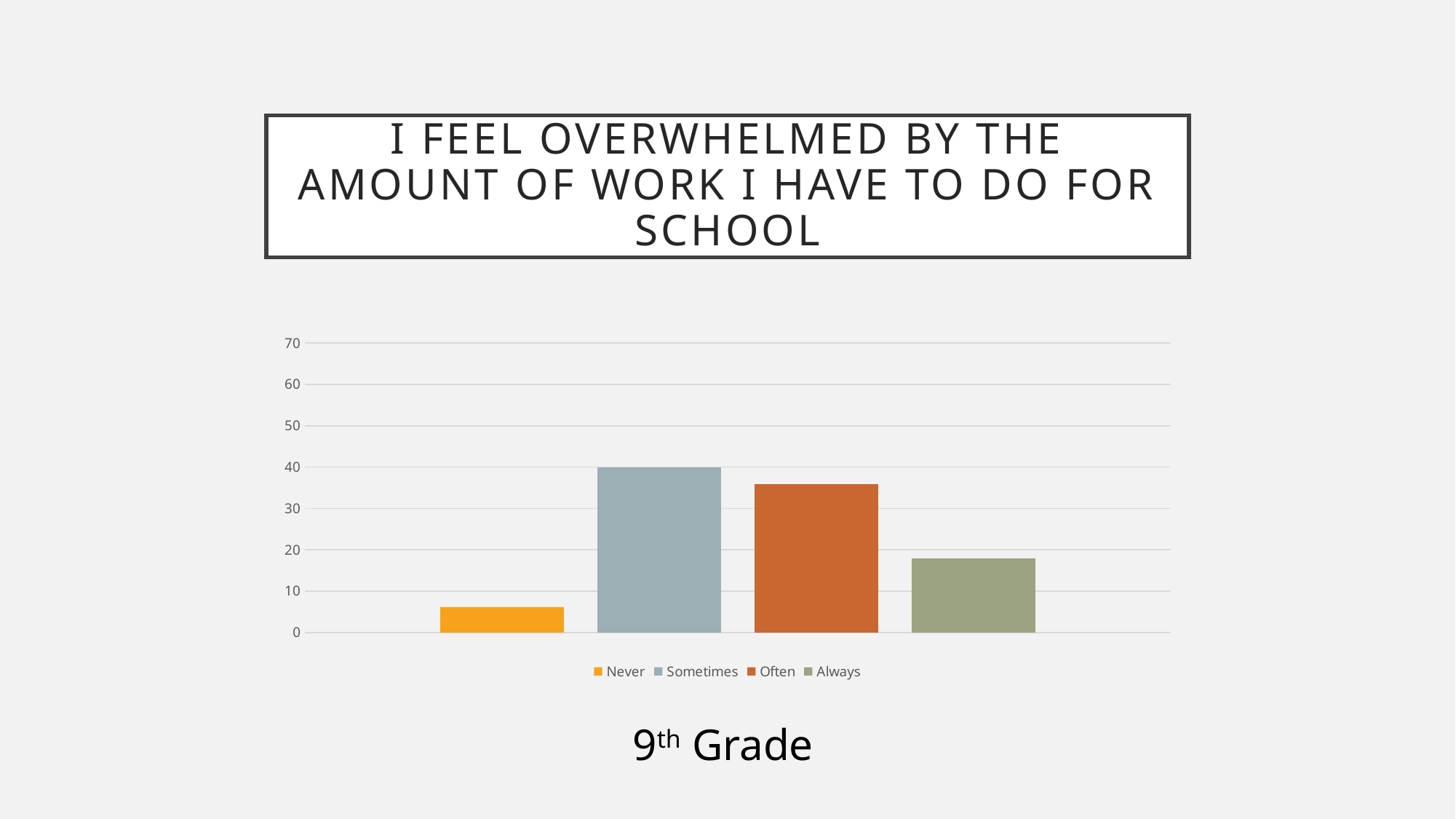
Which response category has the lowest bar? Never Is the value for Always greater or less than 20? less Which response category has the highest bar? Sometimes Is the value for Often greater or less than 40? less How many series does the chart legend list? 4 What is the title of the chart on the slide? I feel overwhelmed by the amount of work I have to do for school Is the value for Often greater or less than 30? greater What is the value for Sometimes? 40 Which is larger, the value for Often or the value for Always? Often What kind of chart is shown on the slide? bar chart Which grade does the chart on the slide refer to? 9th Grade